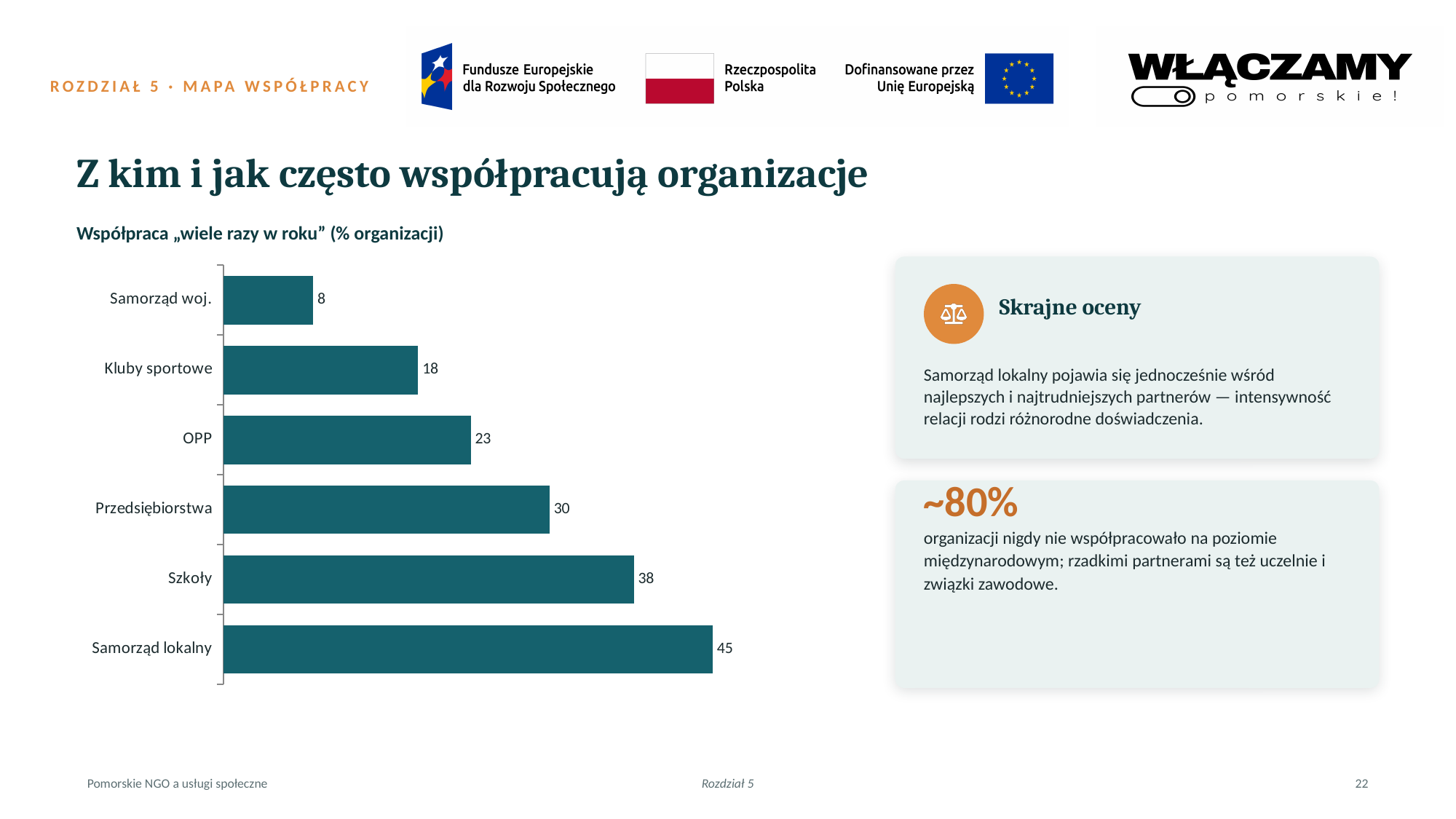
What is the difference between the values for Samorząd lokalny and Samorząd woj.? 37 Which category has the highest value? Samorząd lokalny What kind of chart is shown on the slide? Bar chart Which category has the lowest value? Samorząd woj. What is the value for Przedsiębiorstwa? 30 Which is larger, the value for Szkoły or the value for Przedsiębiorstwa? Szkoły What is the value for Kluby sportowe? 18 What is the title of the chart? Współpraca „wiele razy w roku” (% organizacji) What is the value for OPP? 23 How many categories are shown in the chart? 6 What is the value for Samorząd lokalny? 45 What is the difference between the values for Szkoły and OPP? 15